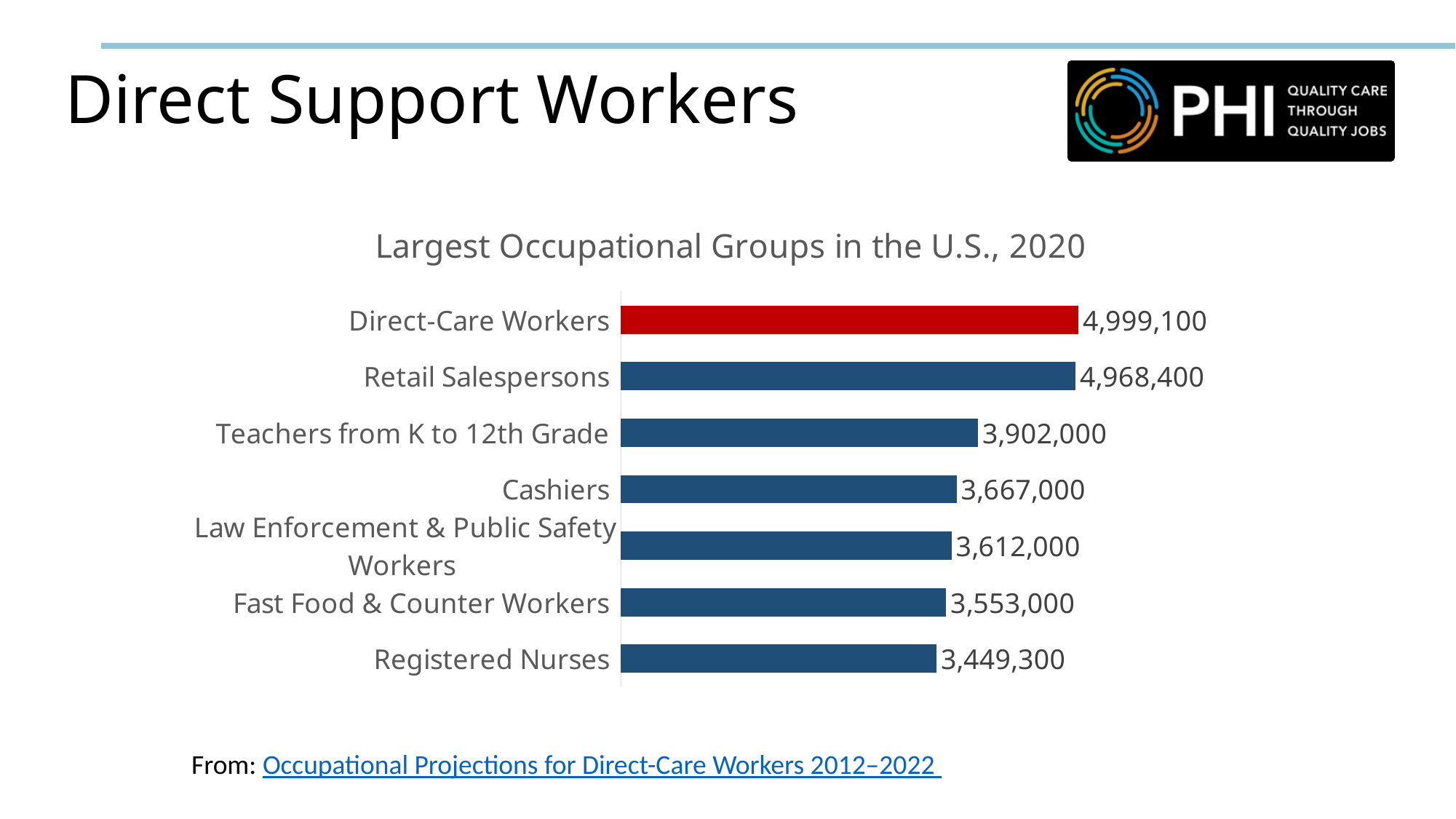
How many occupational groups are shown in the chart? 7 Which occupational group has the highest value? Direct-Care Workers What is the difference between the values for Cashiers and Fast Food & Counter Workers? 114,000 What is the value for Law Enforcement & Public Safety Workers? 3,612,000 Which is larger, the value for Teachers from K to 12th Grade or the value for Cashiers? Teachers from K to 12th Grade What is the value for Direct-Care Workers? 4,999,100 What kind of chart is shown on the slide? Bar chart What is the difference between the values for Direct-Care Workers and Retail Salespersons? 30,700 What is the value for Registered Nurses? 3,449,300 What is the value for Teachers from K to 12th Grade? 3,902,000 What is the title of the chart? Largest Occupational Groups in the U.S., 2020 Which occupational group has the lowest value? Registered Nurses